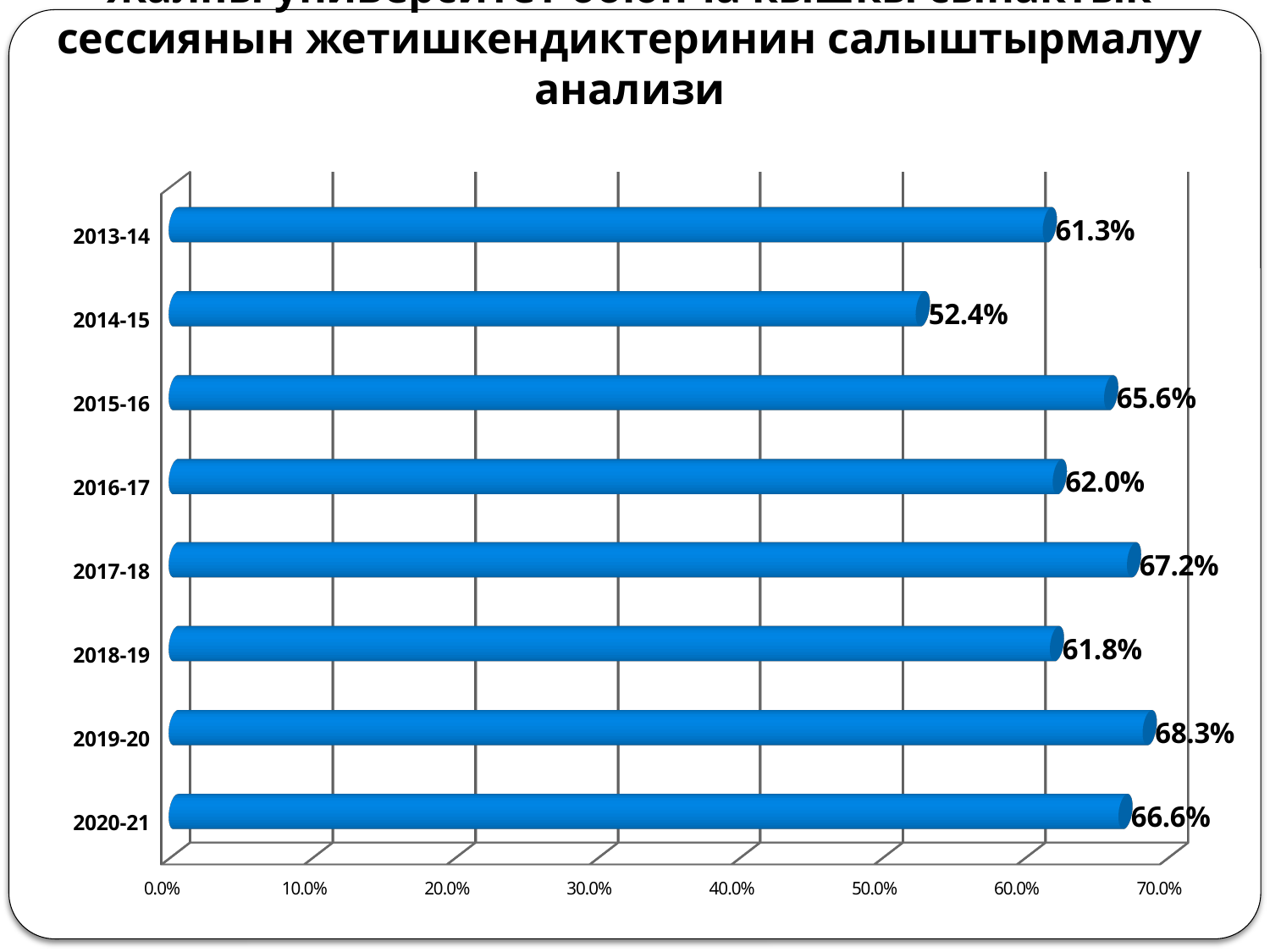
What is the difference between the values for 2013-14 and 2018-19? 0.5% What is the value for 2019-20? 68.3% How many academic years are shown on the chart? 8 What is the value for 2014-15? 52.4% Which academic year has the highest value? 2019-20 Is the value for 2017-18 greater or less than 60.0%? greater What is the value for 2020-21? 66.6% What is the difference between the values for 2019-20 and 2014-15? 15.9% What is the value for 2017-18? 67.2% What kind of chart is shown on the slide? bar chart Which academic year has the lowest value? 2014-15 Which is larger, the value for 2015-16 or the value for 2016-17? 2015-16